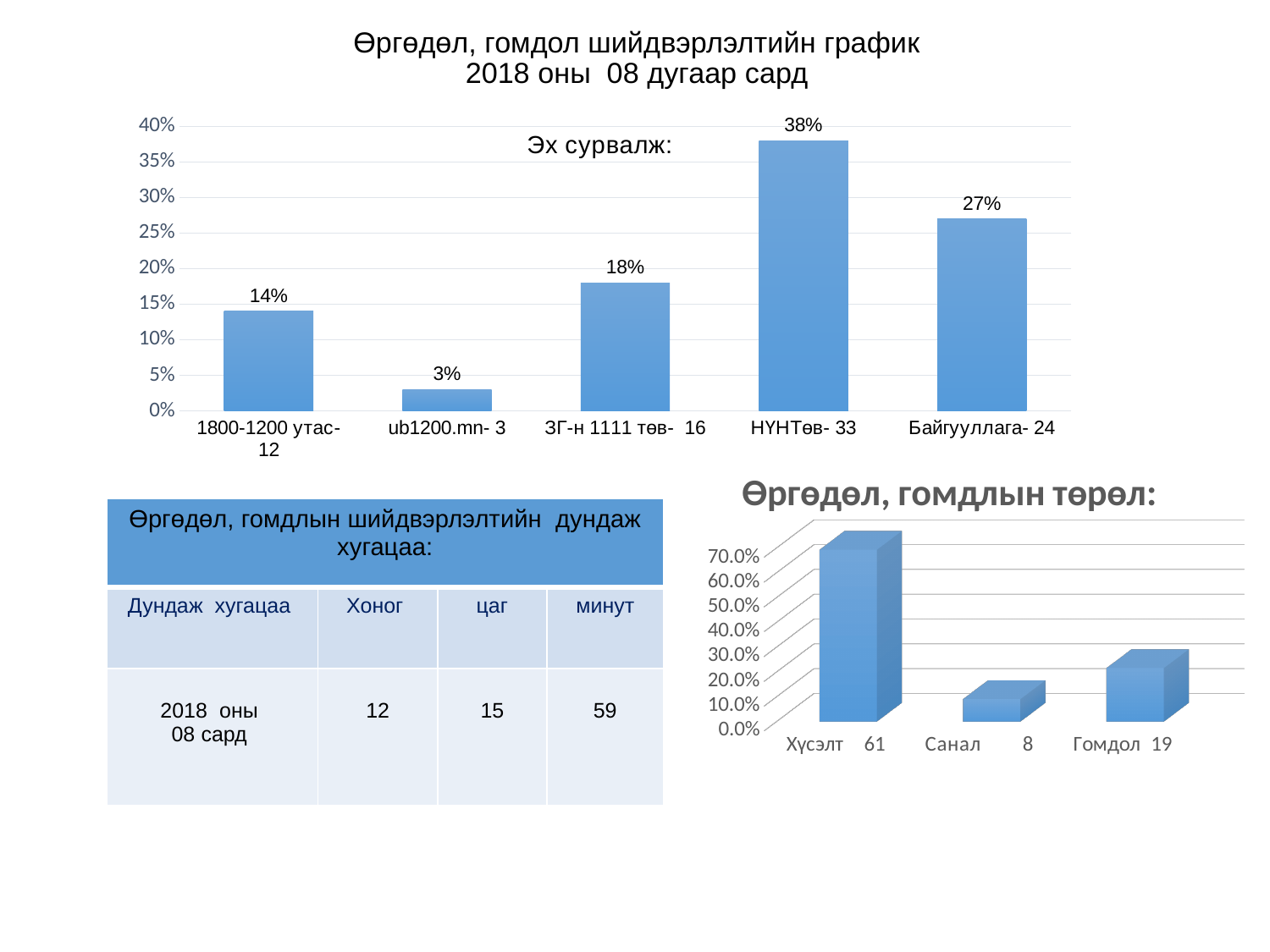
In the top chart (Эх сурвалж), which category has the highest value? НҮНТөв- 33 In the top chart (Эх сурвалж), which is larger: the value for 1800-1200 утас- 12 or the value for ЗГ-н 1111 төв- 16? ЗГ-н 1111 төв- 16 How many categories are shown in the top chart (Эх сурвалж)? 5 In the bottom-right chart (Өргөдөл, гомдлын төрөл), is the value for Хүсэлт greater or less than 60.0%? greater What kind of chart is the bottom-right chart titled Өргөдөл, гомдлын төрөл? bar chart In the top chart (Эх сурвалж), what is the difference between the values for НҮНТөв- 33 and Байгууллага- 24? 11% In the bottom-right chart (Өргөдөл, гомдлын төрөл), is the value for Санал greater or less than 20.0%? less In the top chart (Эх сурвалж), what is the value for НҮНТөв- 33? 38% In the top chart (Эх сурвалж), what is the value for Байгууллага- 24? 27% In the top chart (Эх сурвалж), what is the value for ub1200.mn- 3? 3% In the top chart (Эх сурвалж), which category has the lowest value? ub1200.mn- 3 In the bottom-right chart (Өргөдөл, гомдлын төрөл), which category has the highest value? Хүсэлт